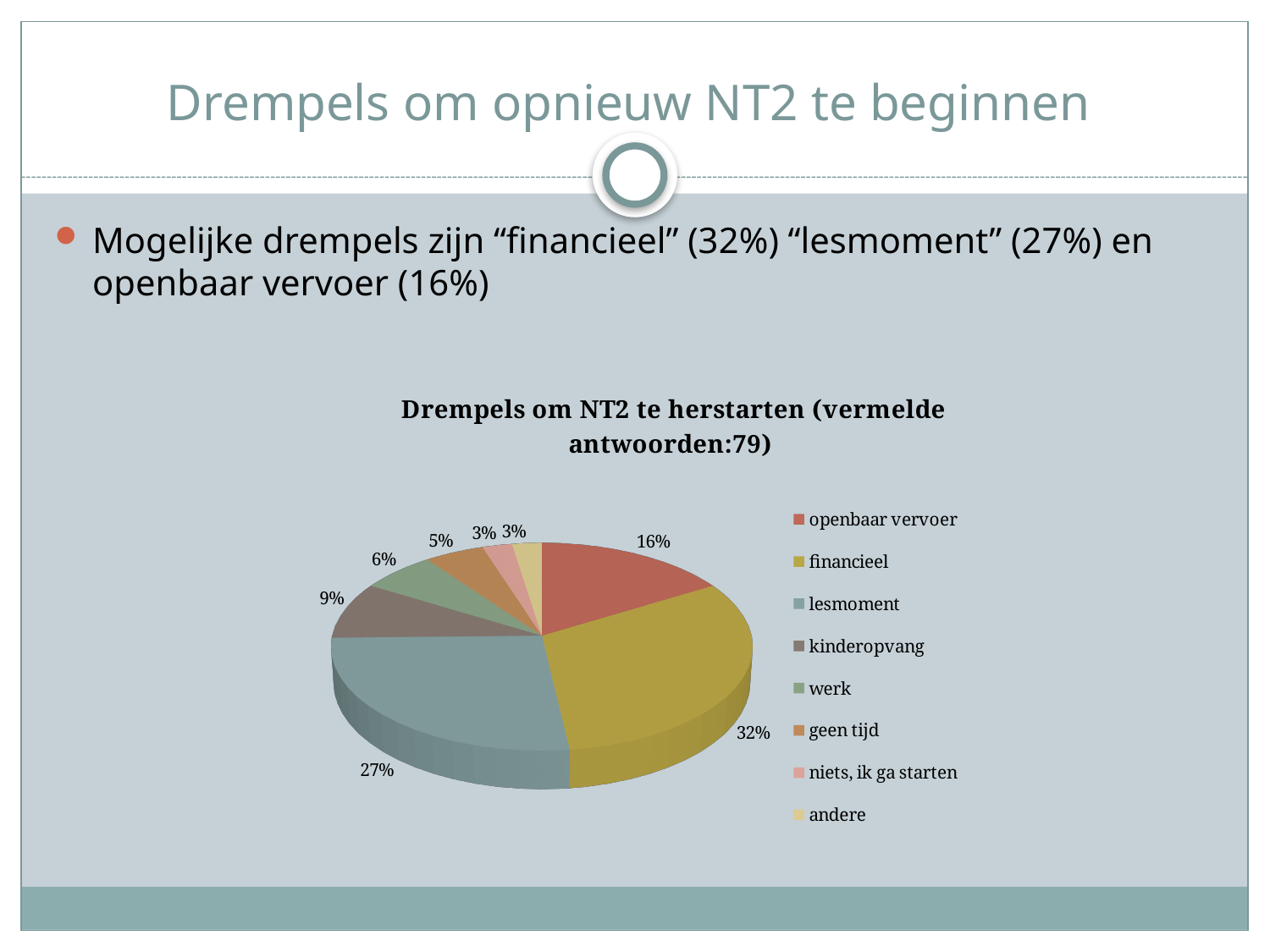
What is the difference in percentage points between "financieel" and "lesmoment"? 5 What is the title of the chart? Drempels om NT2 te herstarten (vermelde antwoorden:79) Which has a larger share, "kinderopvang" or "werk"? kinderopvang What type of chart is shown on the slide? pie chart What percentage of the pie does "werk" represent? 6% Which category has the largest share of the pie? financieel What is the combined share of "financieel" and "openbaar vervoer"? 48% What percentage of the pie does "openbaar vervoer" represent? 16% What percentage of the pie does "kinderopvang" represent? 9% How many categories does the legend list? 8 What percentage of the pie does "lesmoment" represent? 27% What percentage of the pie does "financieel" represent? 32%